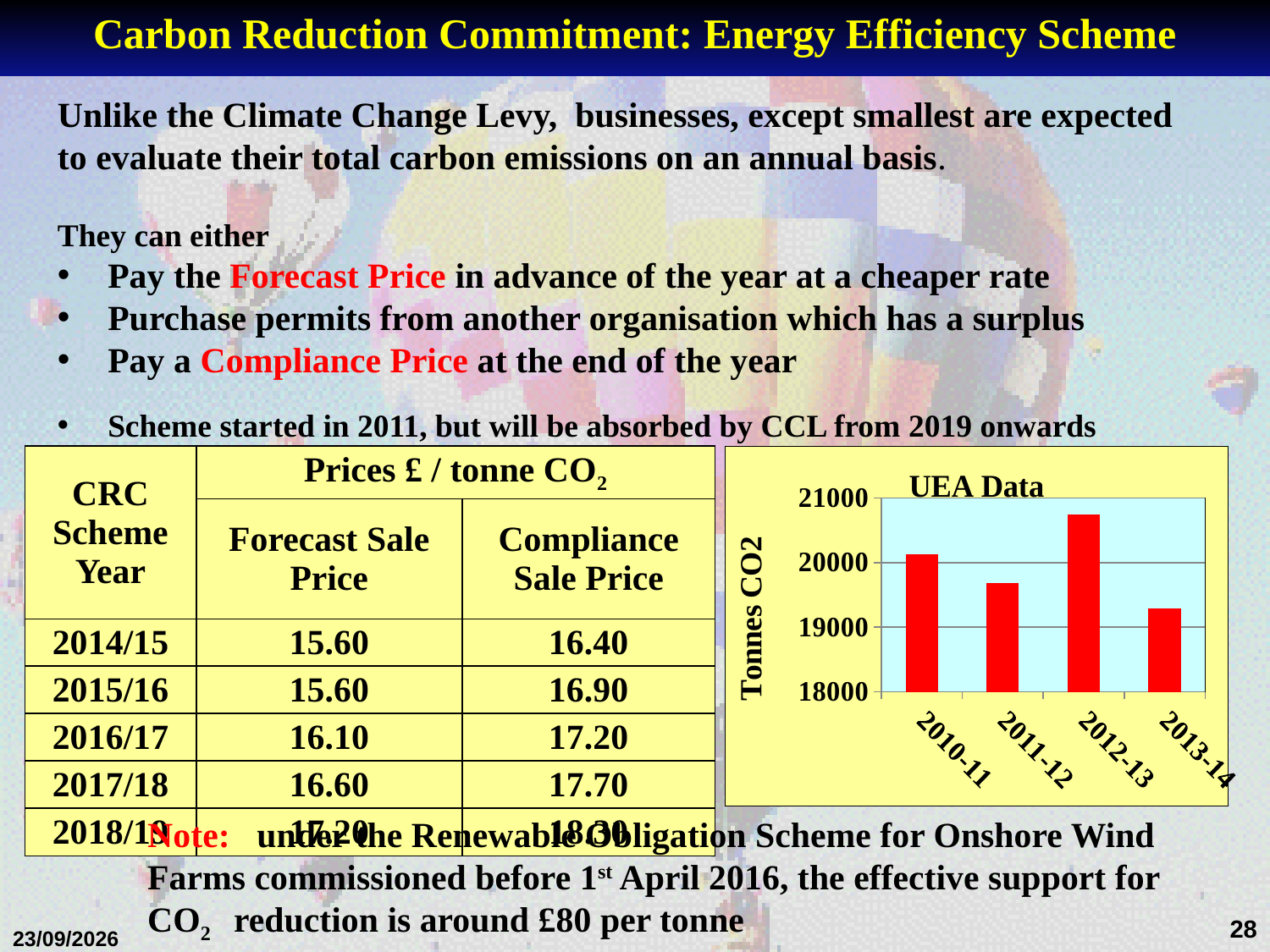
What kind of chart is the UEA Data chart? bar chart What is the title of the bar chart on the slide? UEA Data In the UEA Data chart, do the values rise or fall from 2012-13 to 2013-14? fall Which year has the highest value in the UEA Data chart? 2012-13 In the UEA Data chart, which is larger, the value for 2011-12 or 2013-14? 2011-12 In the UEA Data chart, is the value for 2010-11 greater or less than 20000? greater In the UEA Data chart, is the value for 2011-12 greater or less than 20000? less In the UEA Data chart, which is larger, the value for 2010-11 or 2011-12? 2010-11 Which year has the lowest value in the UEA Data chart? 2013-14 What is the label on the vertical axis of the UEA Data chart? Tonnes CO2 How many years are plotted in the UEA Data chart? 4 In the UEA Data chart, is the value for 2013-14 greater or less than 19000? greater